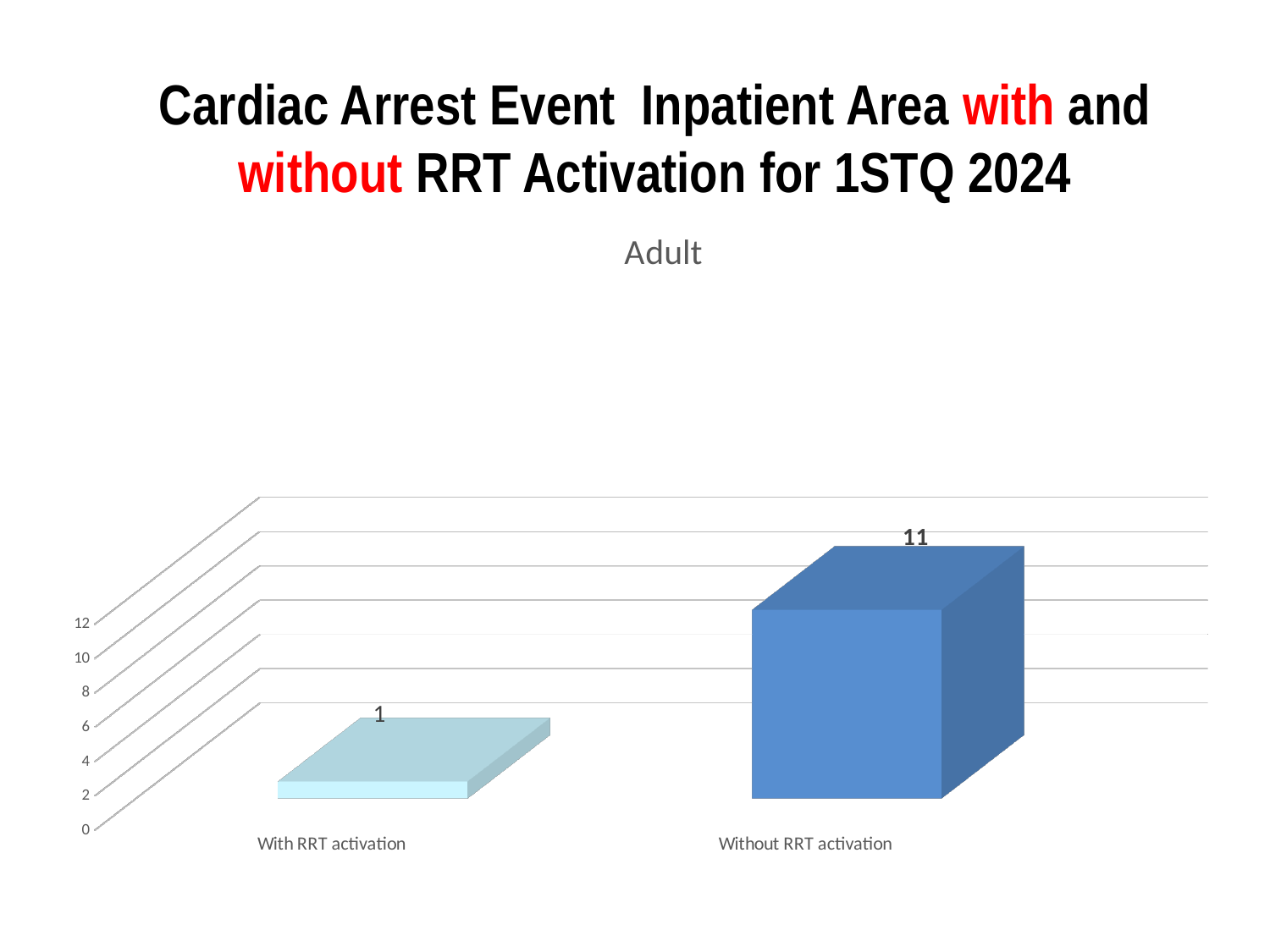
How many categories are shown on the x axis? 2 Which category has the lowest value? With RRT activation Which category has the highest value? Without RRT activation What kind of chart is shown on the slide? bar chart What is the difference between the values for Without RRT activation and With RRT activation? 10 What is the value for With RRT activation? 1 What is the value for Without RRT activation? 11 What is the title of the chart? Adult Is the value for Without RRT activation greater or less than 10? greater What is the total of the two values shown in the chart? 12 Is the value for With RRT activation greater or less than 4? less Which is larger, the value for With RRT activation or the value for Without RRT activation? Without RRT activation